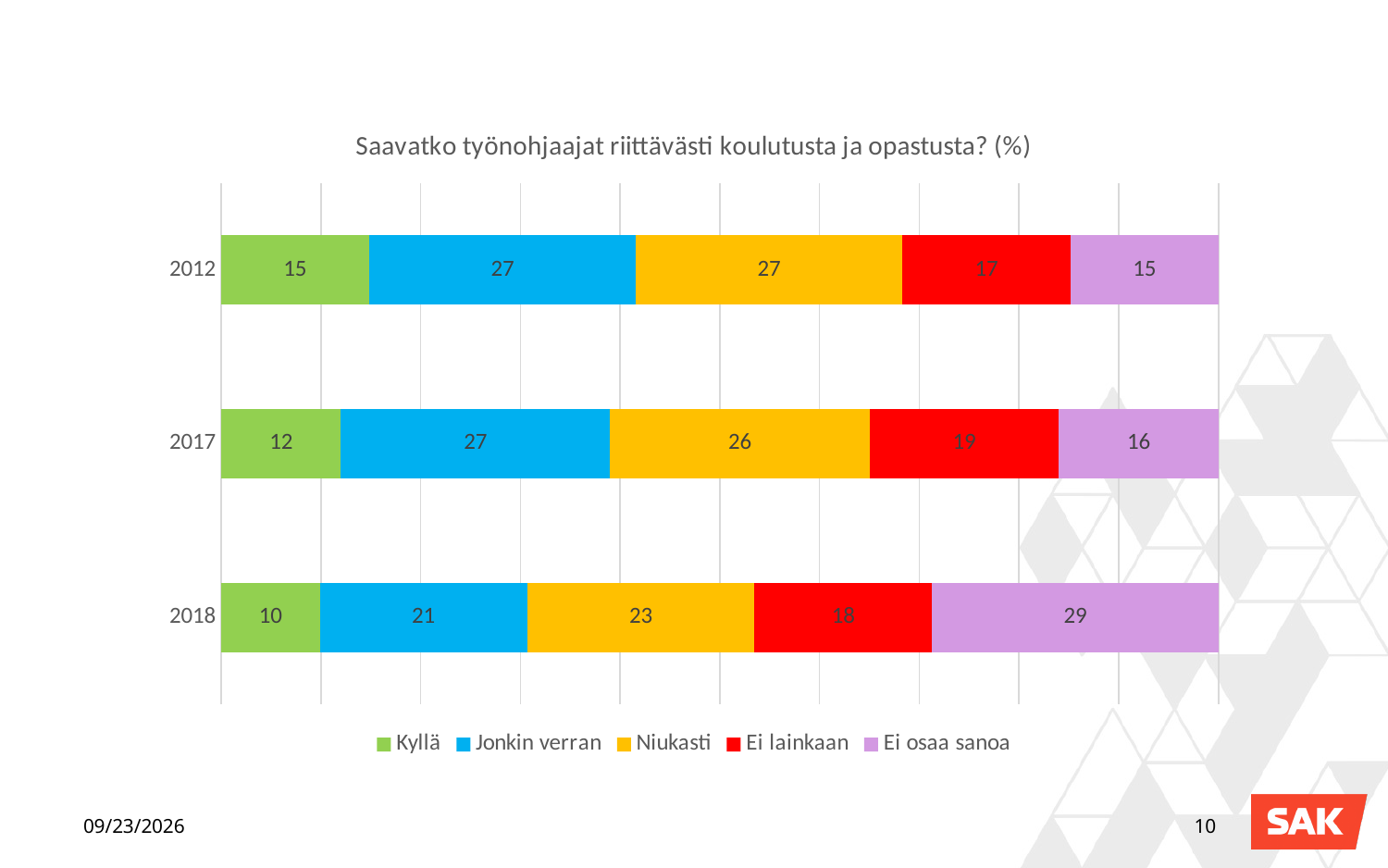
What kind of chart is shown on the slide? Stacked bar chart Which year has the highest value for Ei osaa sanoa? 2018 What is the value for Kyllä in 2012? 15 What is the value for Niukasti in 2018? 23 How many years are shown on the chart? 3 How many series does the legend list? 5 What is the total of the stacked bar for 2017? 100 Which year has the lowest value for Kyllä? 2018 What is the difference between the Jonkin verran values for 2012 and 2018? 6 What is the value for Ei lainkaan in 2017? 19 What is the value for Ei osaa sanoa in 2018? 29 Which is larger, the Niukasti value for 2012 or for 2017? 2012